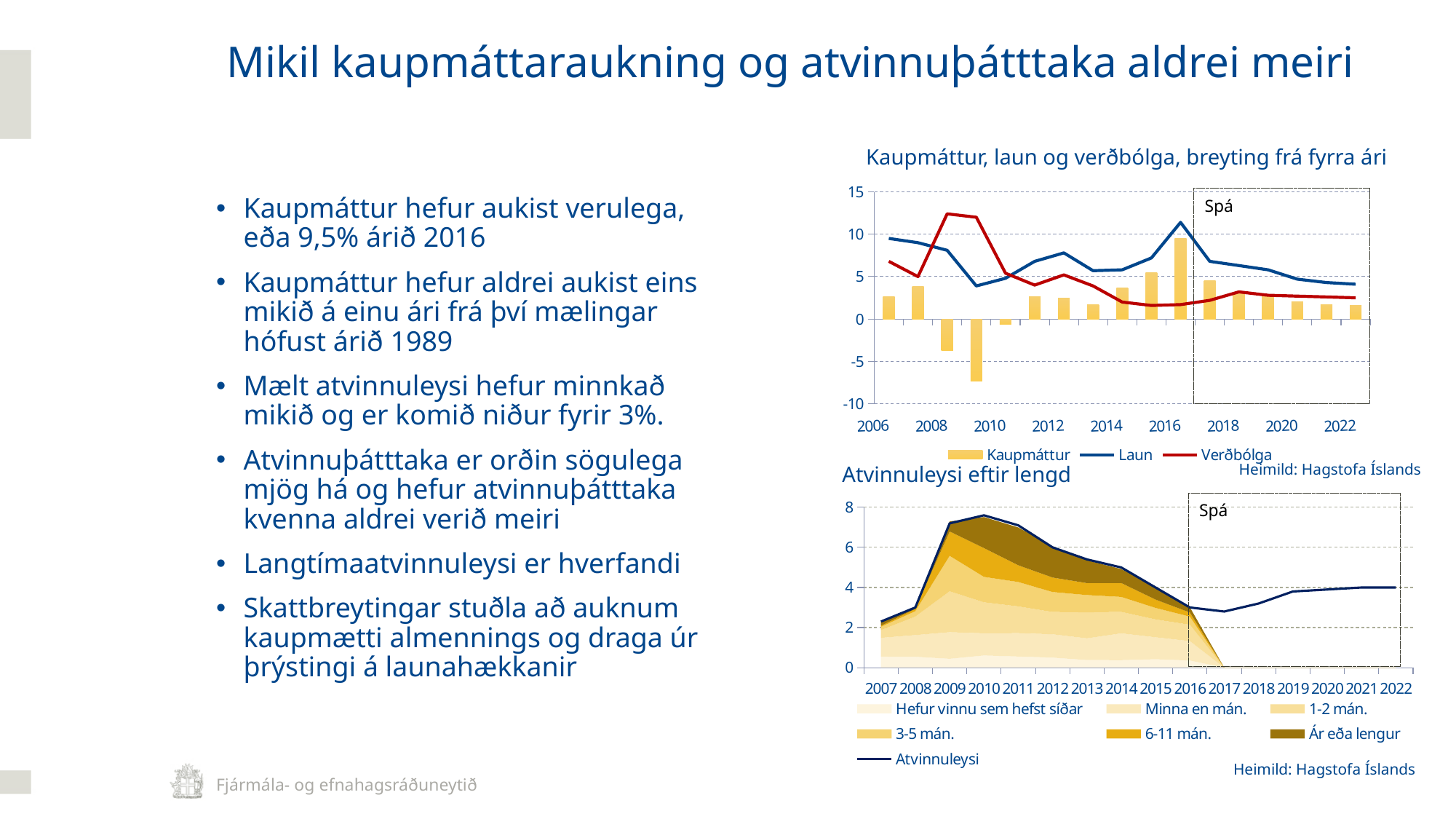
In the top chart 'Kaupmáttur, laun og verðbólga', in which year is the Kaupmáttur bar lowest? 2009 In the bottom chart 'Atvinnuleysi eftir lengd', in which year does the Atvinnuleysi line reach its highest point? 2010 In the top chart 'Kaupmáttur, laun og verðbólga', in which year is the Kaupmáttur bar highest? 2016 In the bottom chart 'Atvinnuleysi eftir lengd', is the Atvinnuleysi value for 2017 greater or less than 4? less In the top chart 'Kaupmáttur, laun og verðbólga', how many series does the legend list? 3 In the top chart 'Kaupmáttur, laun og verðbólga', which series is shown as a red line? Verðbólga In the top chart 'Kaupmáttur, laun og verðbólga', is the Verðbólga value for 2008 greater or less than 10? greater In the bottom chart 'Atvinnuleysi eftir lengd', does the Atvinnuleysi line rise or fall between 2010 and 2017? fall What type of chart is the top chart titled 'Kaupmáttur, laun og verðbólga, breyting frá fyrra ári'? Combined bar and line chart What type of chart is the bottom chart titled 'Atvinnuleysi eftir lengd'? Stacked area chart with a line In the bottom chart 'Atvinnuleysi eftir lengd', how many series does the legend list? 7 In the top chart 'Kaupmáttur, laun og verðbólga', is the Kaupmáttur value for 2016 greater or less than 5? greater